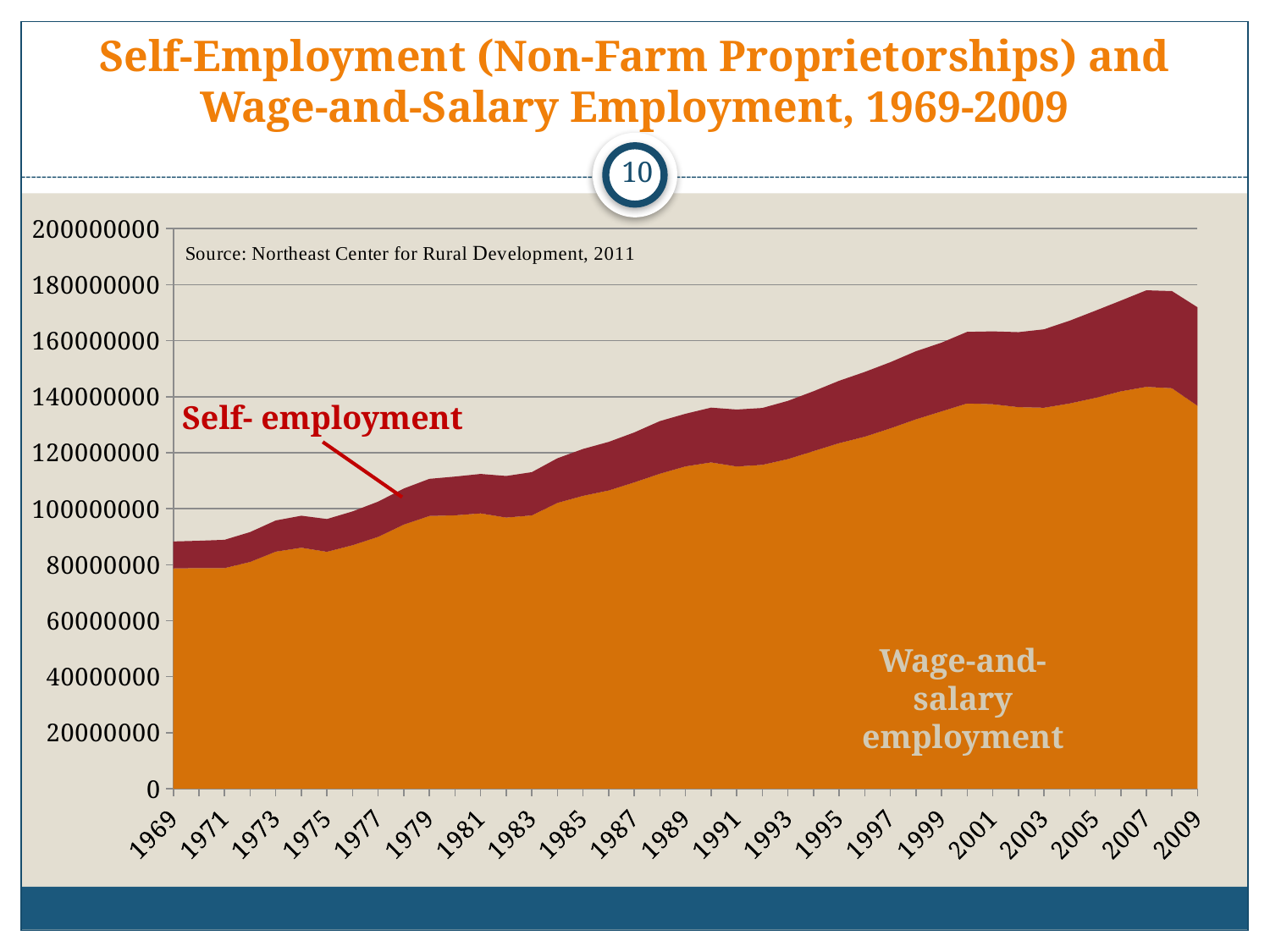
What kind of chart is shown on the slide? Stacked area chart Is the value for wage-and-salary employment in 2009 greater or less than 120000000? greater What is the first year shown on the x axis of the chart? 1969 Which series is larger throughout the chart, self-employment or wage-and-salary employment? Wage-and-salary employment How many data series are plotted in the chart? 2 What source is cited for the chart data? Northeast Center for Rural Development, 2011 Is the combined total of both series in 1969 greater or less than 100000000? less Does total employment (both series combined) generally rise or fall from 1969 to 2009? Rise Is the value for wage-and-salary employment in 1979 greater or less than 100000000? less In which year does the combined total of the two series reach its highest point? 2007